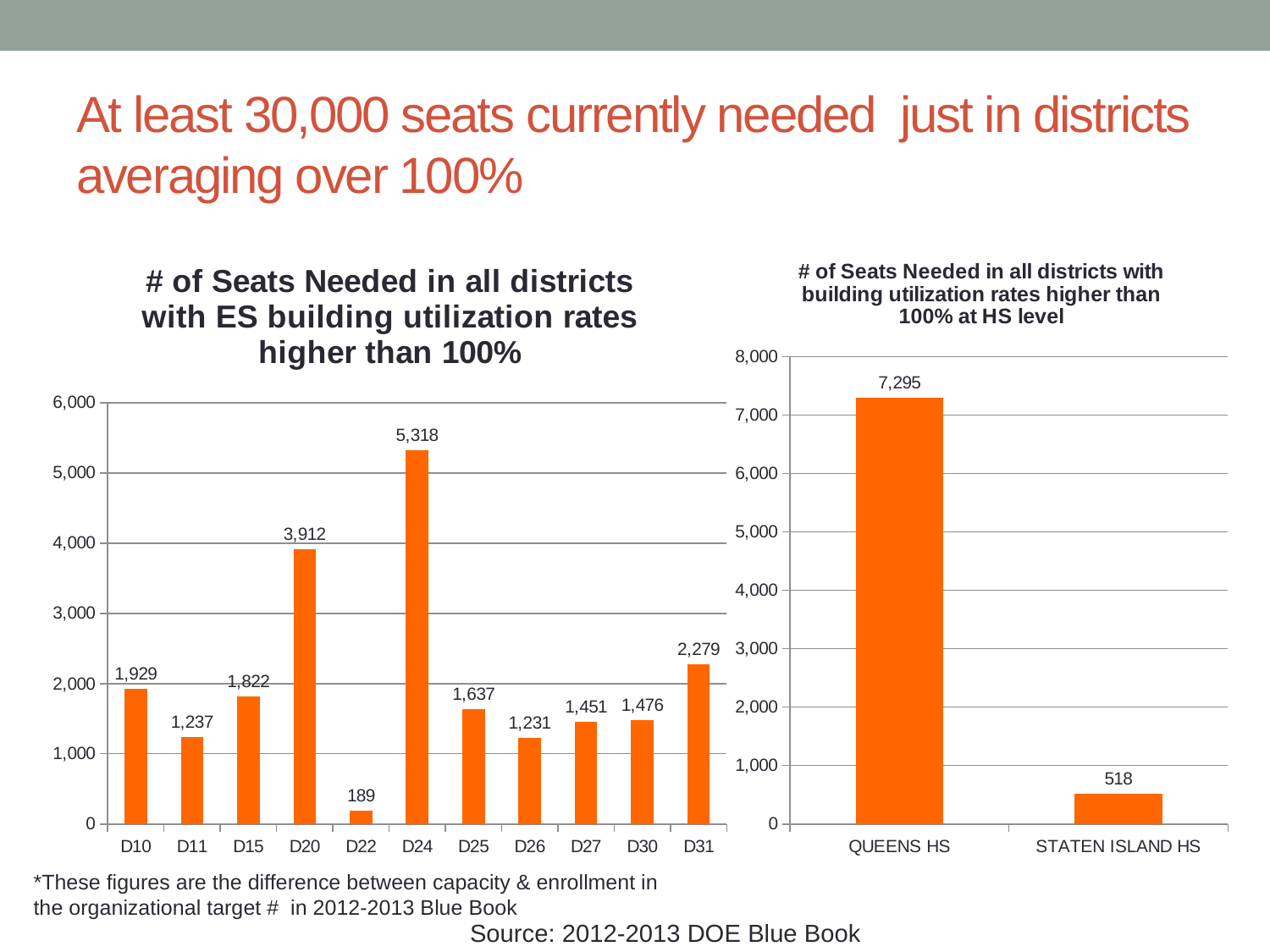
In the left chart (ES building utilization), how many seats are needed in D24? 5,318 What type of chart is the right chart (HS level)? Bar chart In the right chart (HS level), what is the difference between the seats needed in QUEENS HS and STATEN ISLAND HS? 6,777 What is the title of the right chart? # of Seats Needed in all districts with building utilization rates higher than 100% at HS level In the right chart (HS level), how many seats are needed in QUEENS HS? 7,295 In the left chart (ES building utilization), which district has the highest number of seats needed? D24 In the left chart (ES building utilization), how many districts are shown? 11 In the right chart (HS level), how many seats are needed in STATEN ISLAND HS? 518 In the left chart (ES building utilization), which district has the lowest number of seats needed? D22 In the left chart (ES building utilization), how many seats are needed in D22? 189 In the left chart (ES building utilization), what is the difference between the seats needed in D20 and D10? 1,983 In the left chart (ES building utilization), which district needs more seats, D31 or D25? D31